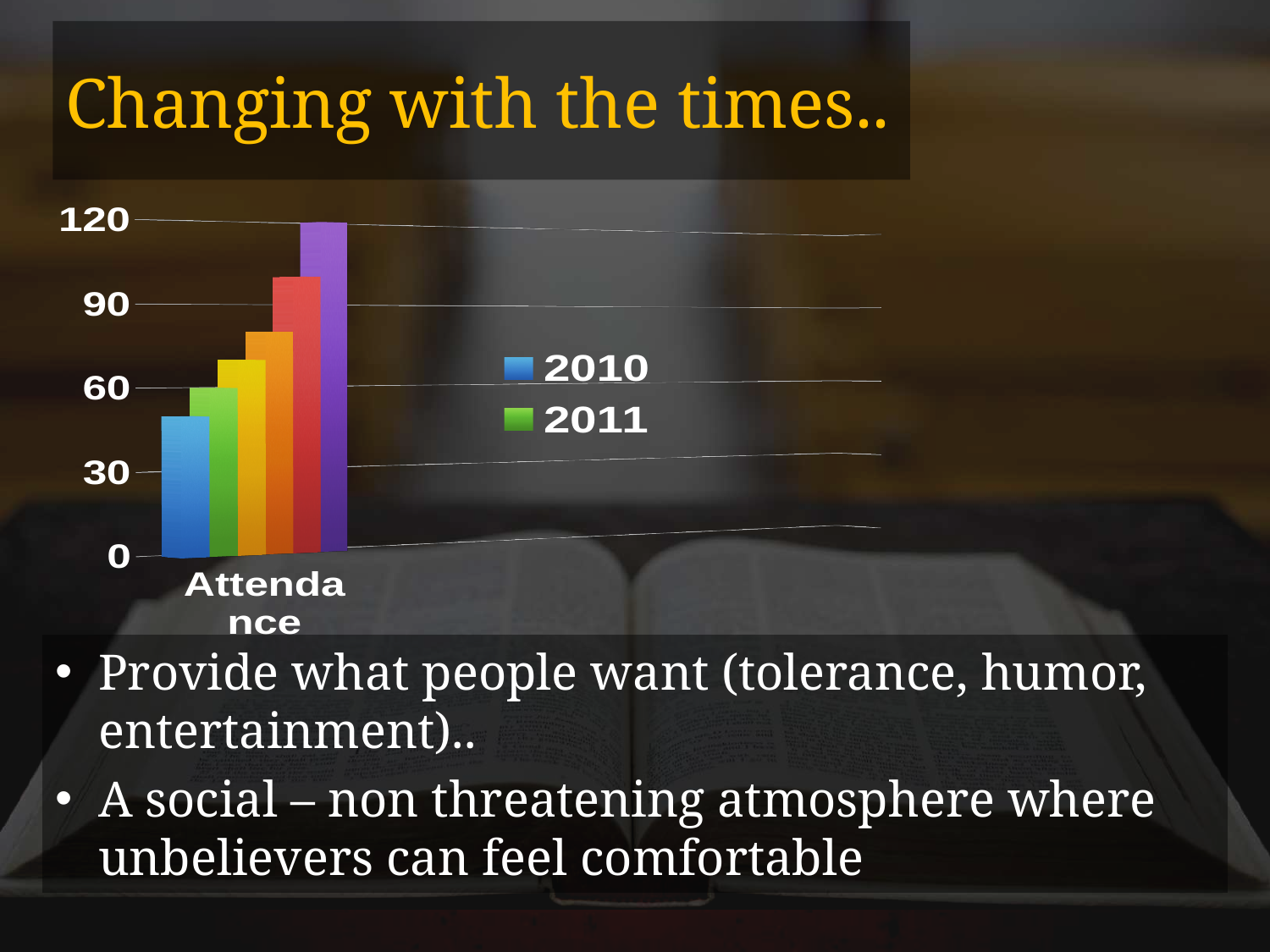
Which two series are named in the chart's legend? 2010 and 2011 Is the value for 2010 greater or less than 30? greater What is the highest value shown on the chart's vertical axis? 120 What is the category label on the x axis of the chart? Attendance Is the tallest bar in the chart greater or less than 90? greater Which is larger, the value for 2010 or the value for 2011? 2011 Is the value for 2010 greater or less than 60? less How many categories are shown on the x axis of the chart? 1 What kind of chart is shown on the slide? bar chart Do the bars in the Attendance category increase or decrease from left to right? increase How many series does the chart's legend list? 2